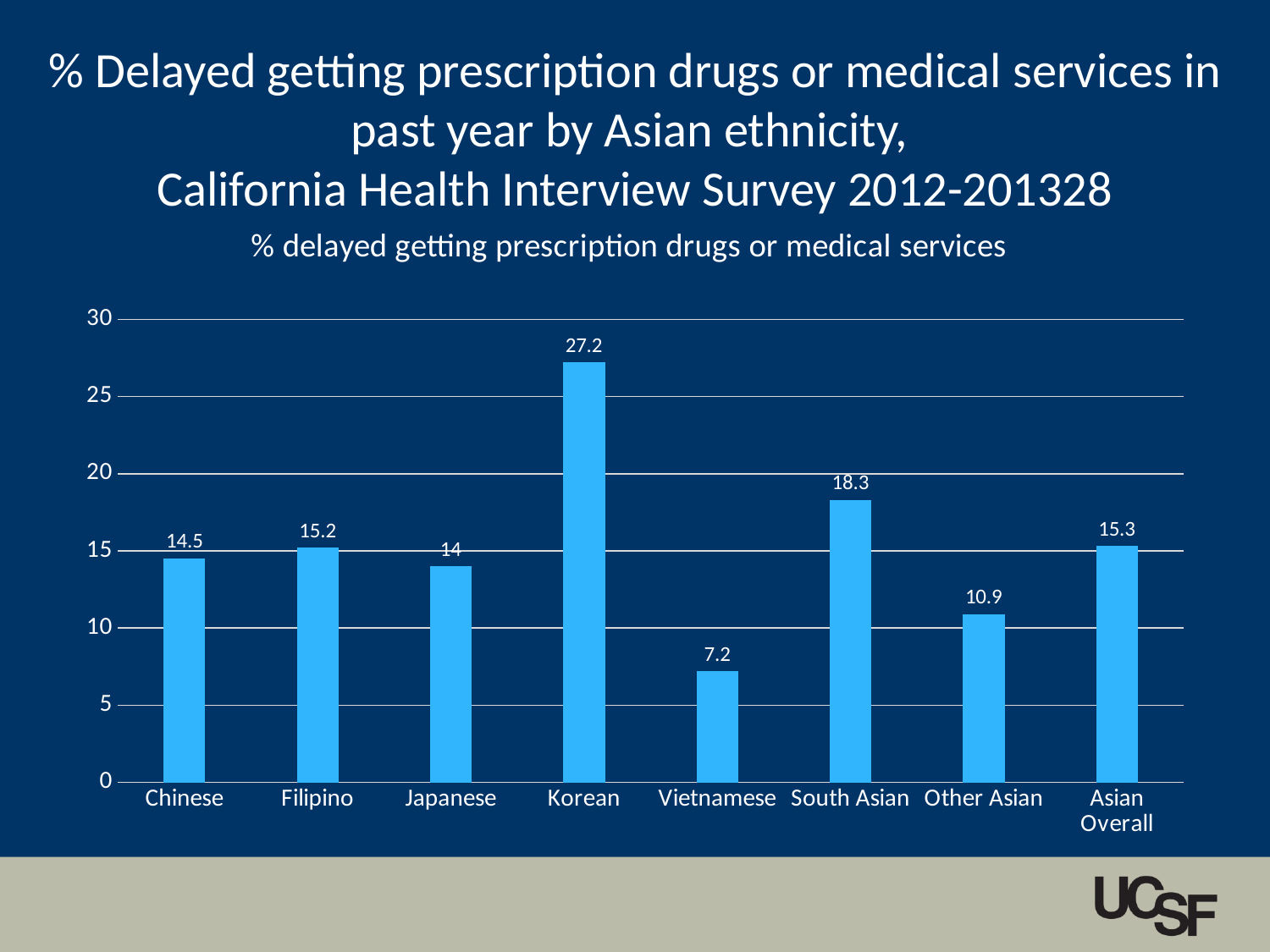
What is the value for Asian Overall? 15.3 Which category has the highest value? Korean What is the value for Korean? 27.2 Which is larger, the value for Filipino or the value for Japanese? Filipino How many categories are shown on the x axis? 8 What is the value for Vietnamese? 7.2 What kind of chart is shown on the slide? bar chart Is the value for South Asian greater or less than 20? less What is the difference between the values for Korean and Vietnamese? 20 What is the difference between the values for South Asian and Other Asian? 7.4 Which category has the lowest value? Vietnamese What is the title of the chart? % delayed getting prescription drugs or medical services